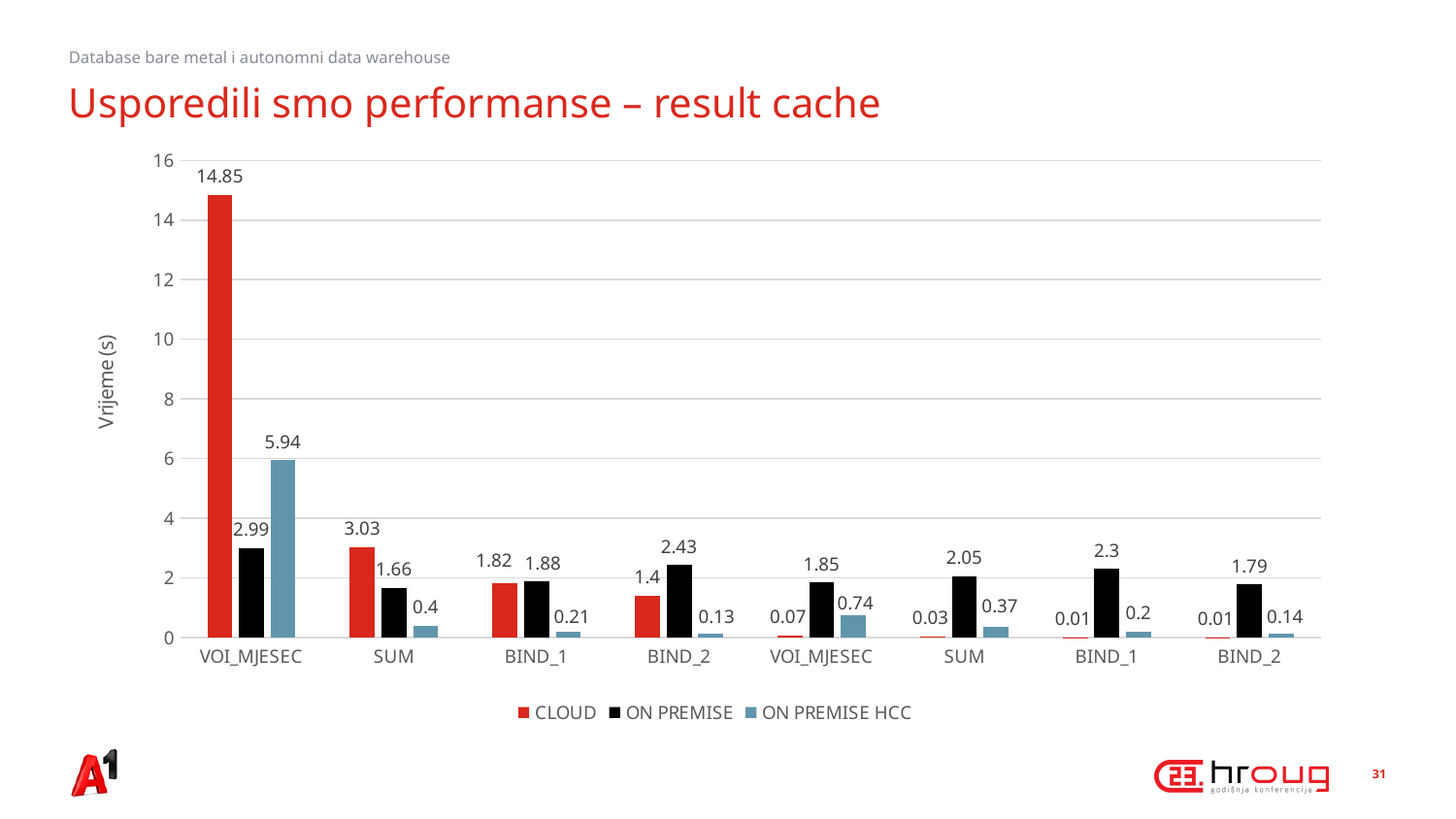
How many category groups are shown along the x axis? 8 What is the CLOUD value for the first (leftmost) VOI_MJESEC category? 14.85 What type of chart is shown on the slide? bar chart What is the ON PREMISE value for the second (right-hand) BIND_1 category? 2.3 What is the difference between the CLOUD and ON PREMISE values in the first (leftmost) VOI_MJESEC category? 11.86 Which series has the lowest value in the second (right-hand) SUM category? CLOUD What is the ON PREMISE HCC value for the first (leftmost) VOI_MJESEC category? 5.94 How many series does the legend list? 3 In the first (leftmost) BIND_2 category, which is larger: the CLOUD value or the ON PREMISE value? ON PREMISE What colour are the ON PREMISE bars? black Which series has the highest value in the first (leftmost) VOI_MJESEC category? CLOUD What is the label of the y axis? Vrijeme (s)